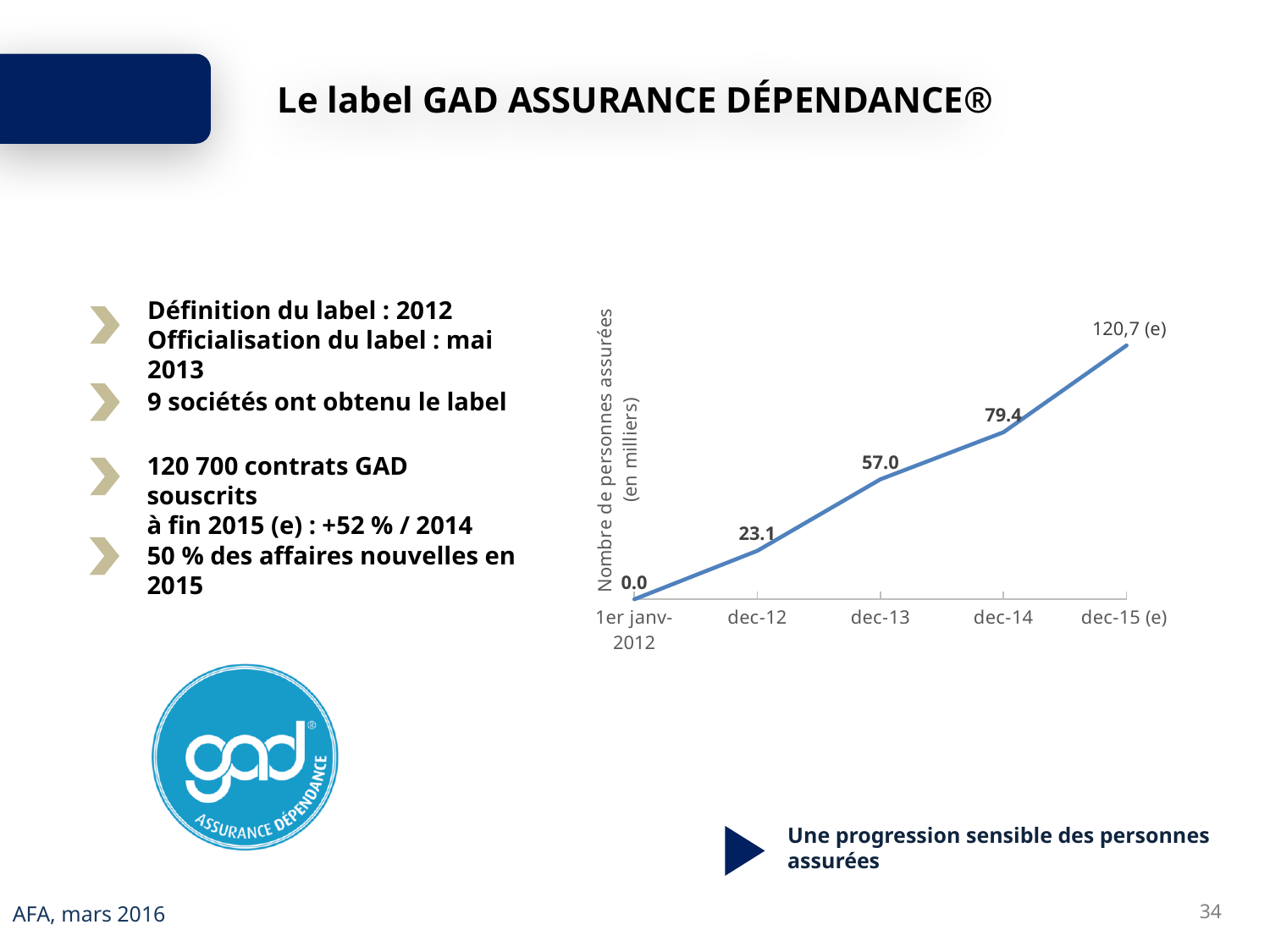
What is the value for dec-12? 23.1 How many data points are plotted on the line? 5 What is the value for 1er janv-2012? 0.0 Which is larger, the value for dec-12 or the value for dec-13? dec-13 Do the values rise or fall from 1er janv-2012 to dec-15 (e)? rise What kind of chart is shown on the slide? line chart What is the value for dec-13? 57.0 Which point on the x axis has the highest value? dec-15 (e) What is the value labelled for dec-15 (e)? 120,7 (e) Which point on the x axis has the lowest value? 1er janv-2012 What is the value for dec-14? 79.4 What is the difference between the values for dec-14 and dec-13? 22.4